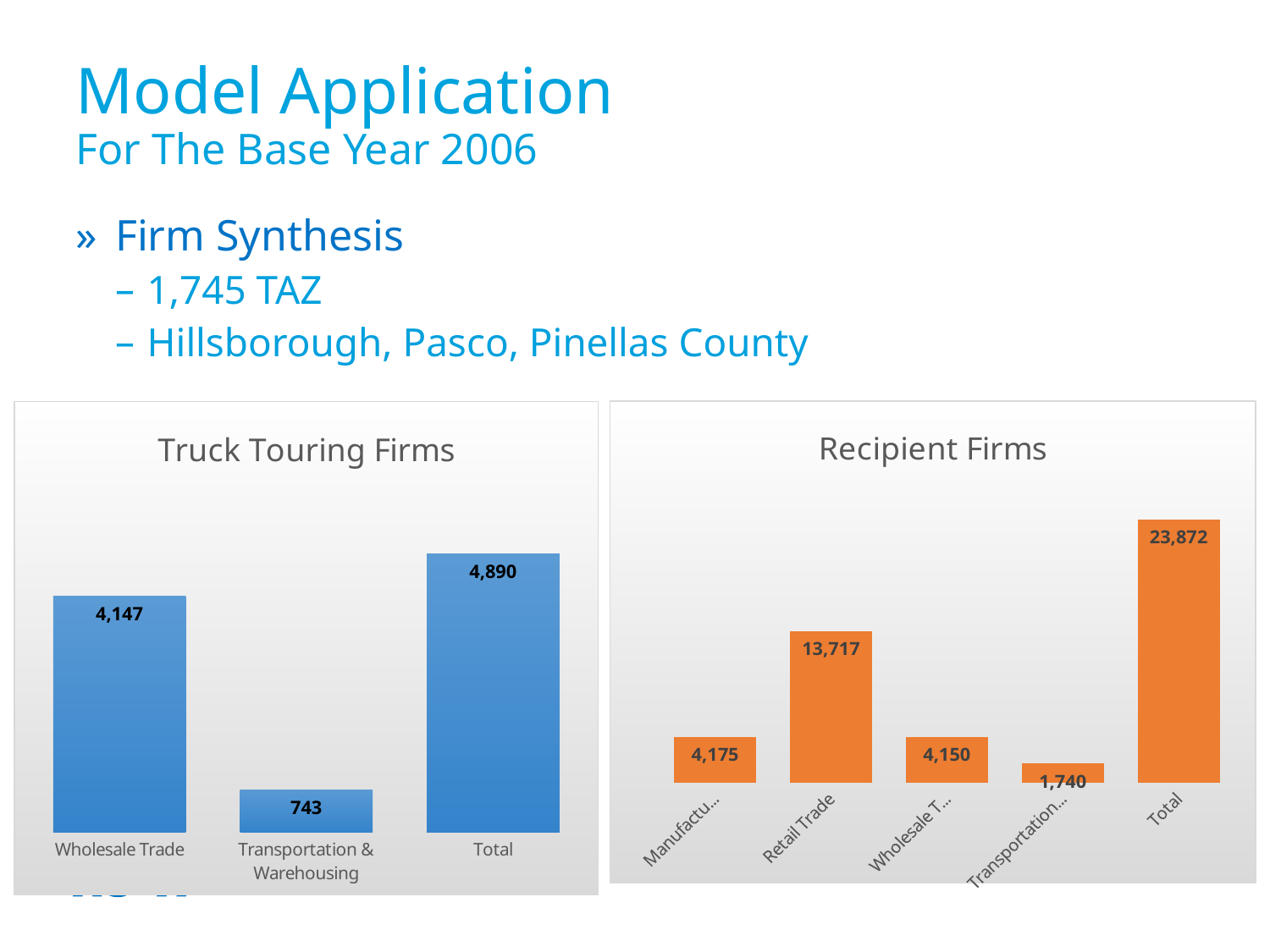
In the Recipient Firms chart, what is the difference between the Total bar and Retail Trade? 10,155 How many bars are shown in the Recipient Firms chart? 5 In the Truck Touring Firms chart, what is the value for Wholesale Trade? 4,147 What type of chart is the Recipient Firms chart? Bar chart How many bars are shown in the Truck Touring Firms chart? 3 In the Truck Touring Firms chart, what is the difference between Wholesale Trade and Transportation & Warehousing? 3,404 In the Recipient Firms chart, what is the value for Retail Trade? 13,717 In the Truck Touring Firms chart, what is the value for Transportation & Warehousing? 743 In the Truck Touring Firms chart, what is the value of the Total bar? 4,890 In the Recipient Firms chart, what is the value of the Total bar? 23,872 In the Truck Touring Firms chart, which category has the lowest value? Transportation & Warehousing In the Recipient Firms chart, excluding the Total bar, which category has the highest value? Retail Trade